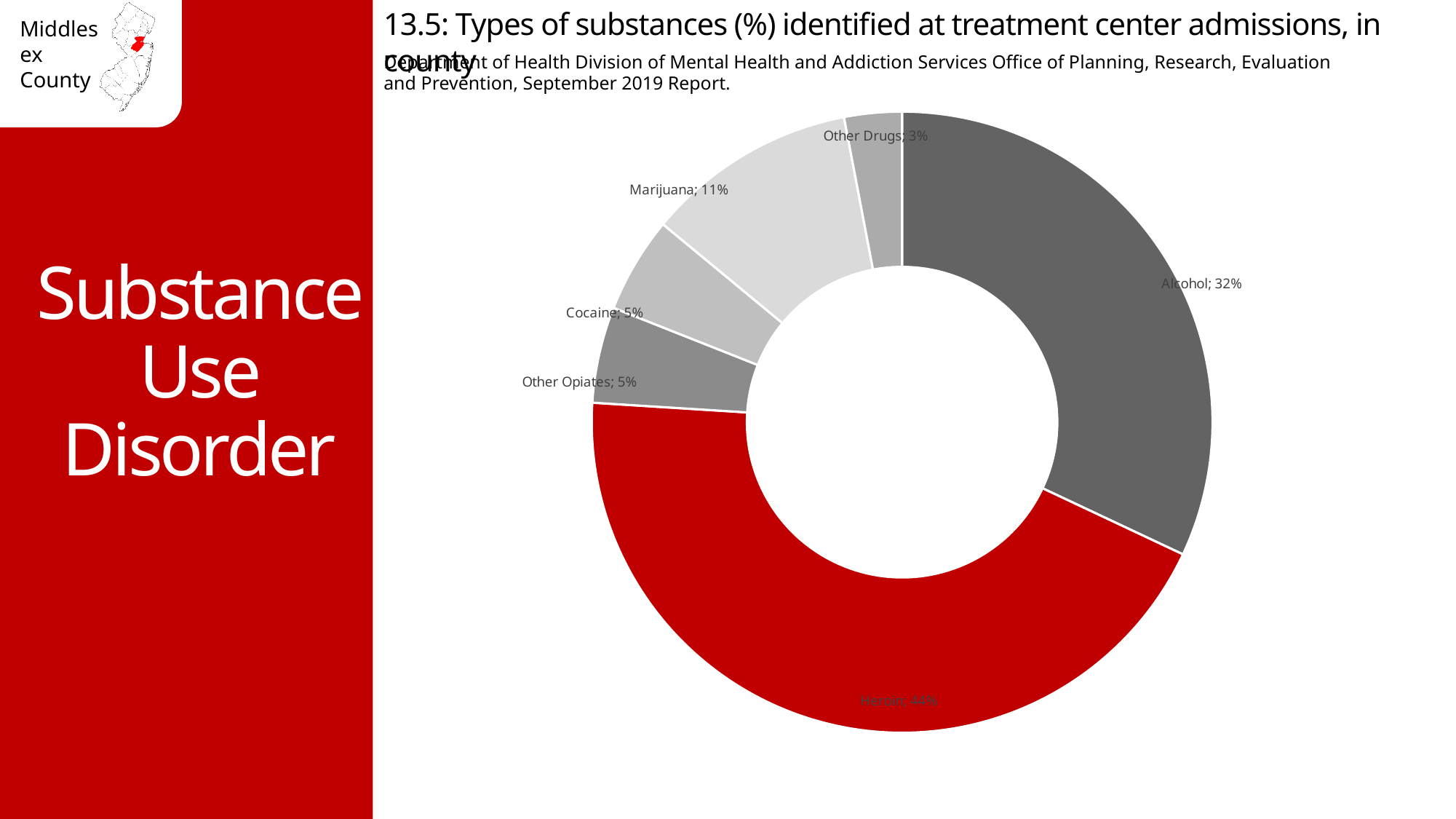
What is the difference in percentage points between Heroin and Alcohol? 12 What percentage of treatment center admissions is attributed to Marijuana? 11% Which substance has the largest share of treatment center admissions? Heroin How many substance categories are shown in the chart? 6 What percentage of treatment center admissions is attributed to Alcohol? 32% Which slice of the chart is coloured red? Heroin What kind of chart is shown on the slide? Doughnut chart What percentage of treatment center admissions is attributed to Heroin? 44% Which substance has the smallest share of treatment center admissions? Other Drugs What is the combined share of Other Opiates and Cocaine? 10% Which has a larger share, Marijuana or Cocaine? Marijuana What percentage of treatment center admissions is attributed to Other Drugs? 3%